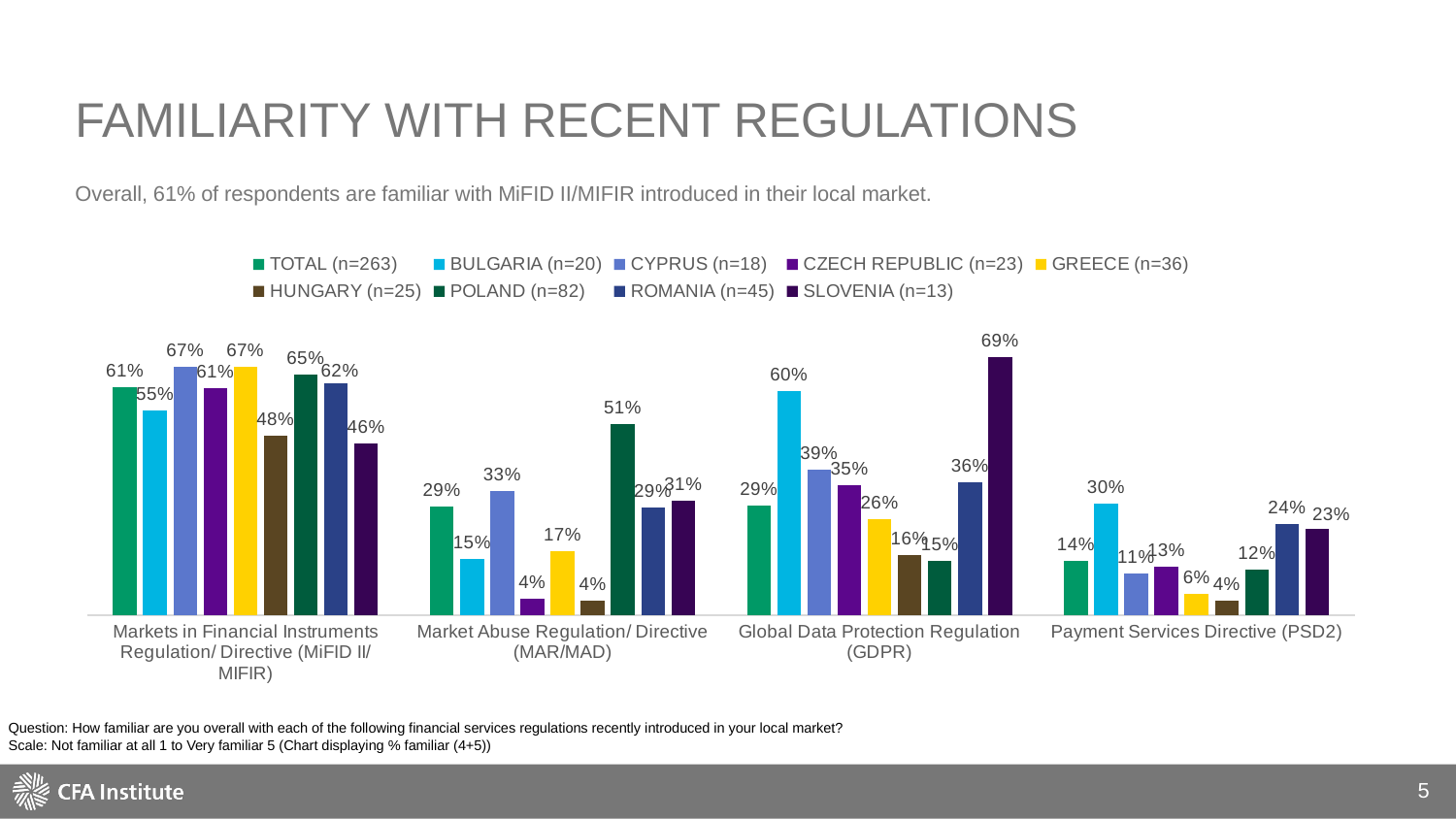
What is the value for BULGARIA in the Global Data Protection Regulation (GDPR) category? 60% What kind of chart is shown on the slide? Bar chart What is the sample size (n) for POLAND shown in the legend? 82 What is the value for POLAND in the Market Abuse Regulation/ Directive (MAR/MAD) category? 51% How many regulation categories are shown on the x axis? 4 What is the value for HUNGARY in the Market Abuse Regulation/ Directive (MAR/MAD) category? 4% How many series does the legend list? 9 Which is larger for Payment Services Directive (PSD2): BULGARIA or ROMANIA? BULGARIA Which country has the lowest value for Payment Services Directive (PSD2)? HUNGARY What is the difference between SLOVENIA and TOTAL for Global Data Protection Regulation (GDPR)? 40% Which country has the highest value for Global Data Protection Regulation (GDPR)? SLOVENIA What is the TOTAL value for Markets in Financial Instruments Regulation/ Directive (MiFID II/ MIFIR)? 61%